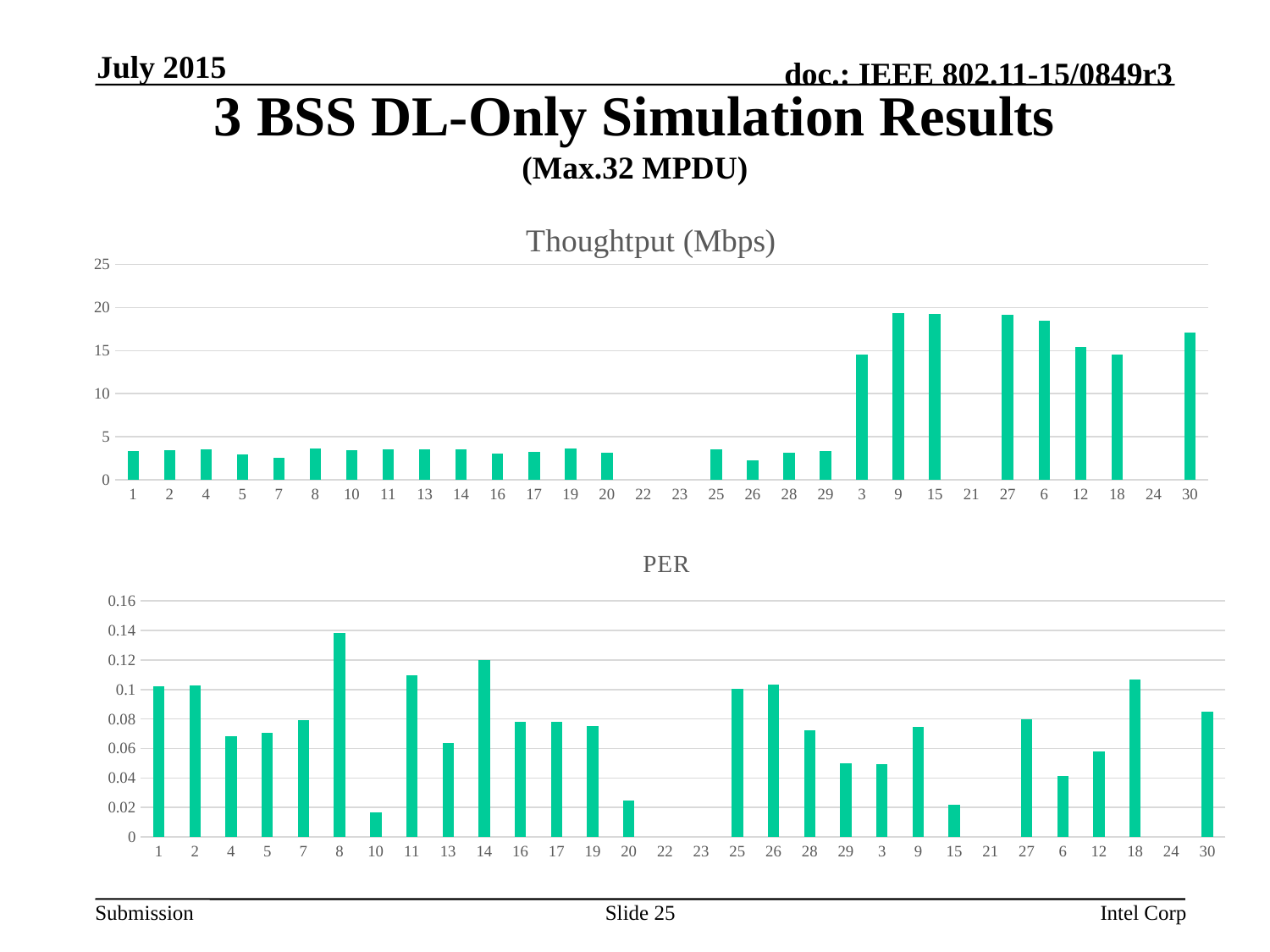
In the Thoughtput (Mbps) chart, is the value for category 30 greater or less than 15? greater In the Thoughtput (Mbps) chart, which has the larger value, category 6 or category 12? 6 In the Thoughtput (Mbps) chart, is the value for category 1 greater or less than 5? less In the PER chart, which has the larger value, category 1 or category 4? 1 In the PER chart, is the value for category 10 greater or less than 0.02? less What kind of chart is the Thoughtput (Mbps) chart? bar chart How many categories are labelled on the x axis of the PER chart? 30 In the Thoughtput (Mbps) chart, which has the larger value, category 9 or category 1? 9 What is the title of the top chart on the slide? Thoughtput (Mbps) In the PER chart, which category has the highest value? 8